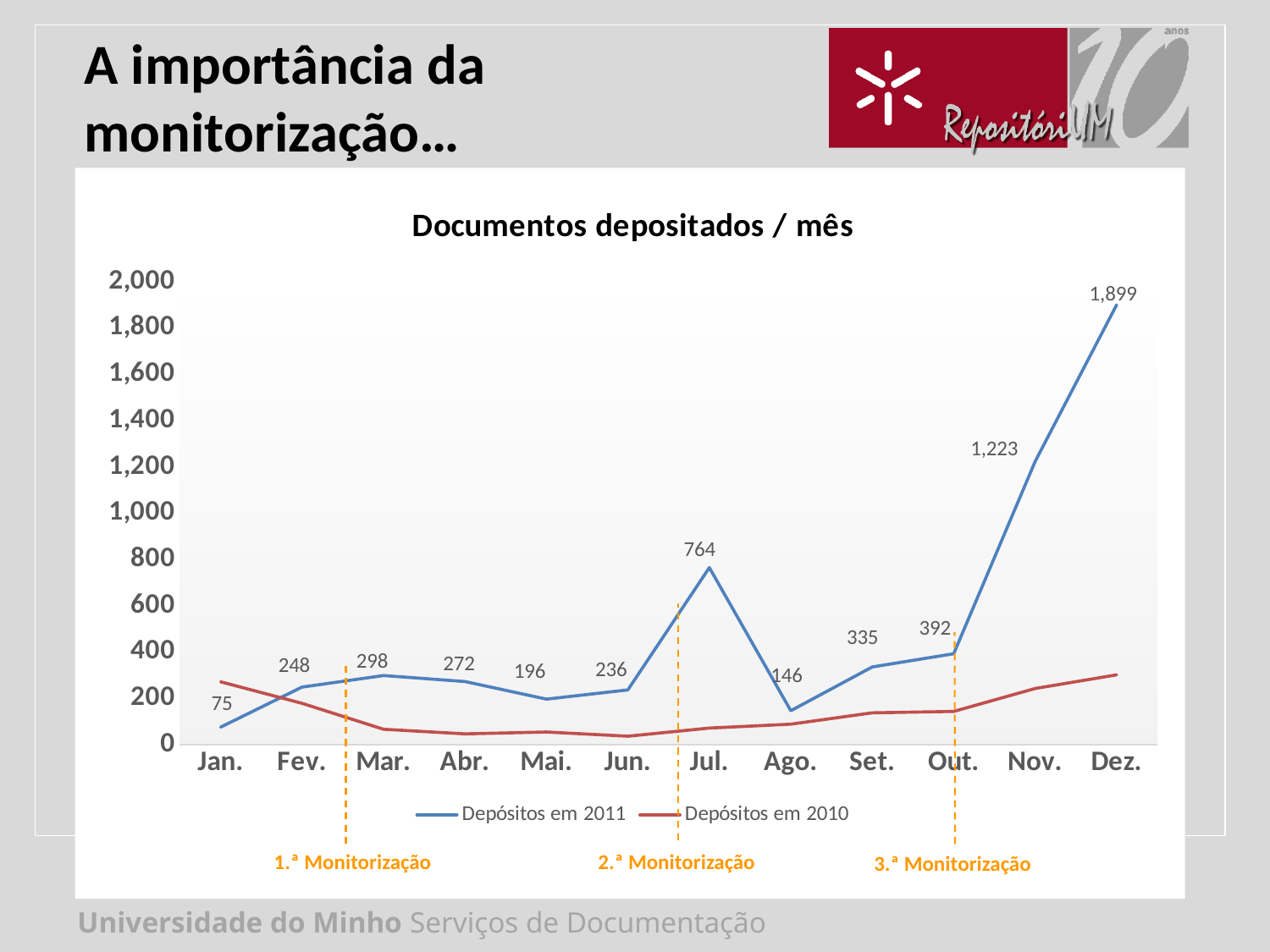
How many months are shown on the x axis? 12 Is the value for Depósitos em 2010 in Jan. greater or less than 200? greater What is the value for Depósitos em 2011 in Dez.? 1,899 What is the value for Depósitos em 2011 in Jan.? 75 What is the value for Depósitos em 2011 in Jul.? 764 How many series does the legend list? 2 Which is larger for Depósitos em 2011: Mar. or Abr.? Mar. What is the difference between the Depósitos em 2011 values for Dez. and Nov.? 676 What is the title of the chart? Documentos depositados / mês What type of chart is shown on the slide? Line chart Which month has the highest value for Depósitos em 2011? Dez. Which month has the lowest value for Depósitos em 2011? Jan.